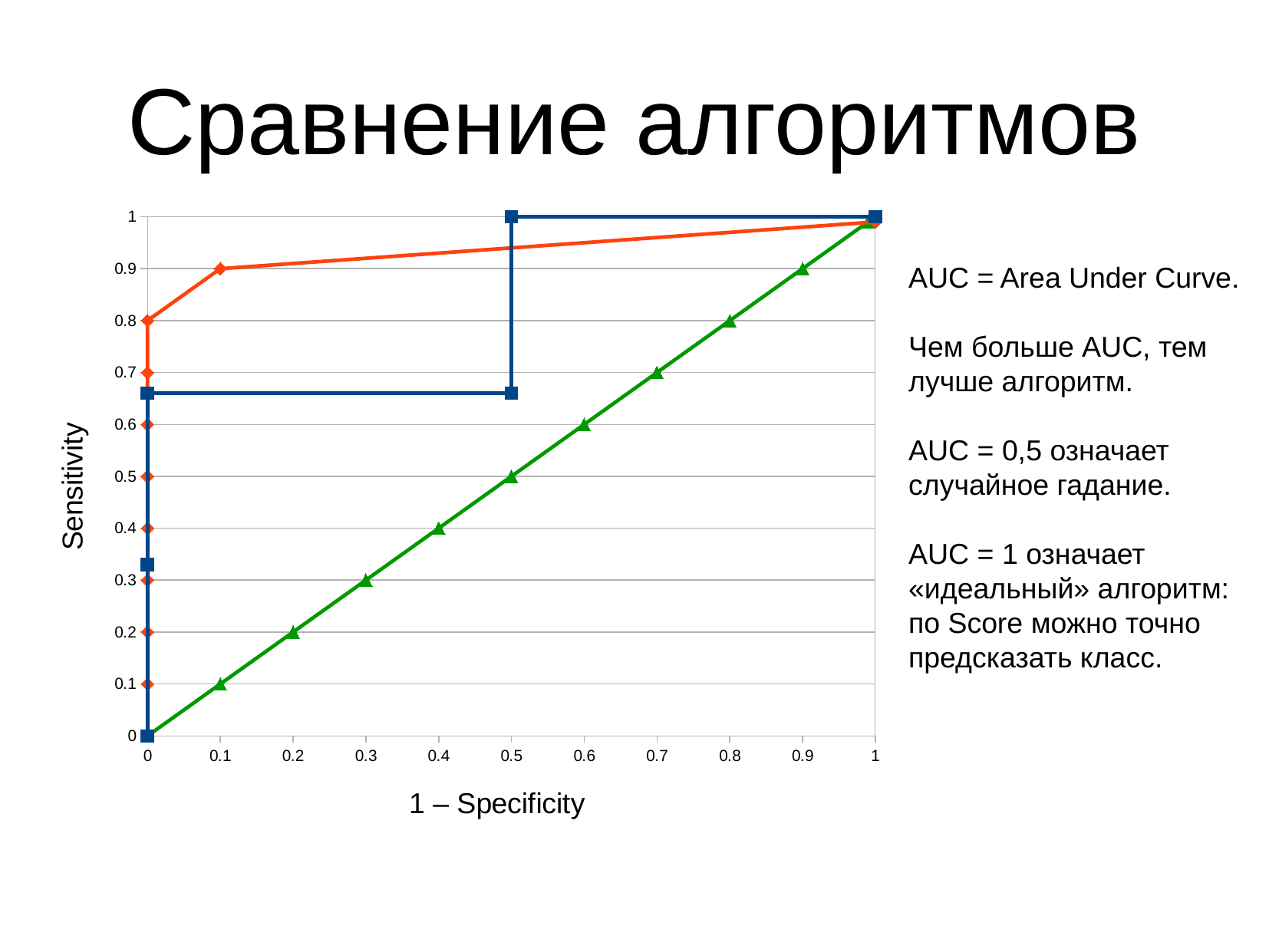
Is the Sensitivity value of the blue line at 1 – Specificity = 0.3 greater or less than 0.5? greater How many lines (series) are plotted on the chart? 3 What is the Sensitivity value of the green line at 1 – Specificity = 0.8? 0.8 How many marked points does the green line have? 11 Is the Sensitivity value of the orange line at 1 – Specificity = 0.5 greater or less than 0.9? greater At 1 – Specificity = 0.1, which line has the higher Sensitivity, the orange line or the green line? orange line Does the green line rise or fall as 1 – Specificity increases? rise What is the Sensitivity value of the green line at 1 – Specificity = 0.5? 0.5 What is the title of the x axis of the chart? 1 – Specificity What kind of chart is shown on the slide? line chart What is the title of the y axis of the chart? Sensitivity What is the Sensitivity value of the orange line at 1 – Specificity = 0.1? 0.9